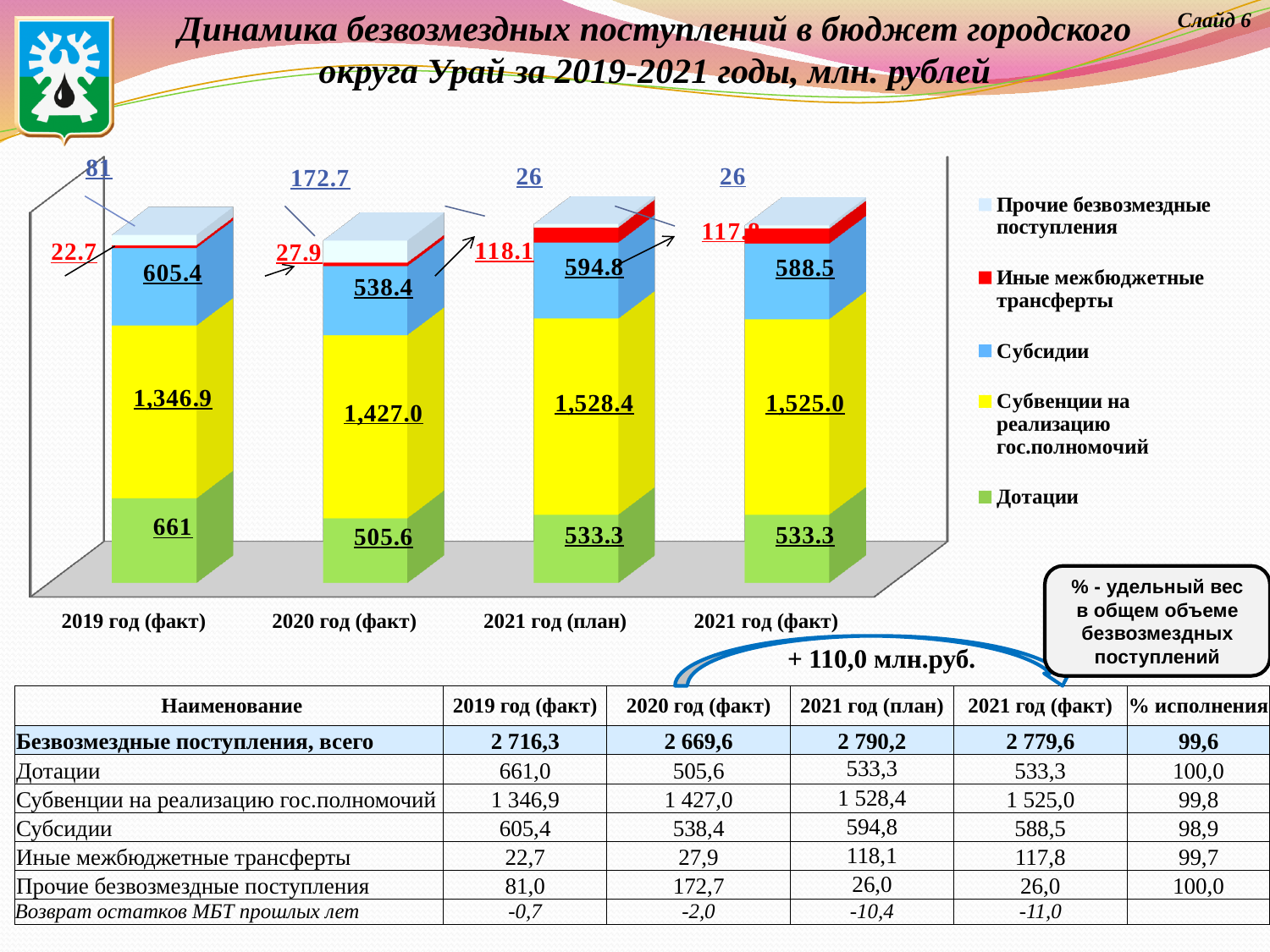
What is the value of Прочие безвозмездные поступления for 2020 год (факт)? 172.7 What is the value of Субвенции на реализацию гос.полномочий for 2019 год (факт)? 1,346.9 What is the difference between the Дотации values for 2019 год (факт) and 2020 год (факт)? 155.4 How many year categories are shown along the x axis of the chart? 4 In which year category is the Субвенции на реализацию гос.полномочий value the highest? 2021 год (план) In which year category is the Дотации value the lowest? 2020 год (факт) How many series does the chart legend list? 5 Which is larger: Субсидии for 2019 год (факт) or Субсидии for 2020 год (факт)? 2019 год (факт) Which series is shown in yellow in the chart? Субвенции на реализацию гос.полномочий What type of chart is shown on the slide? Stacked bar chart What is the value of Дотации for 2020 год (факт)? 505.6 What is the value of Субсидии for 2021 год (план)? 594.8